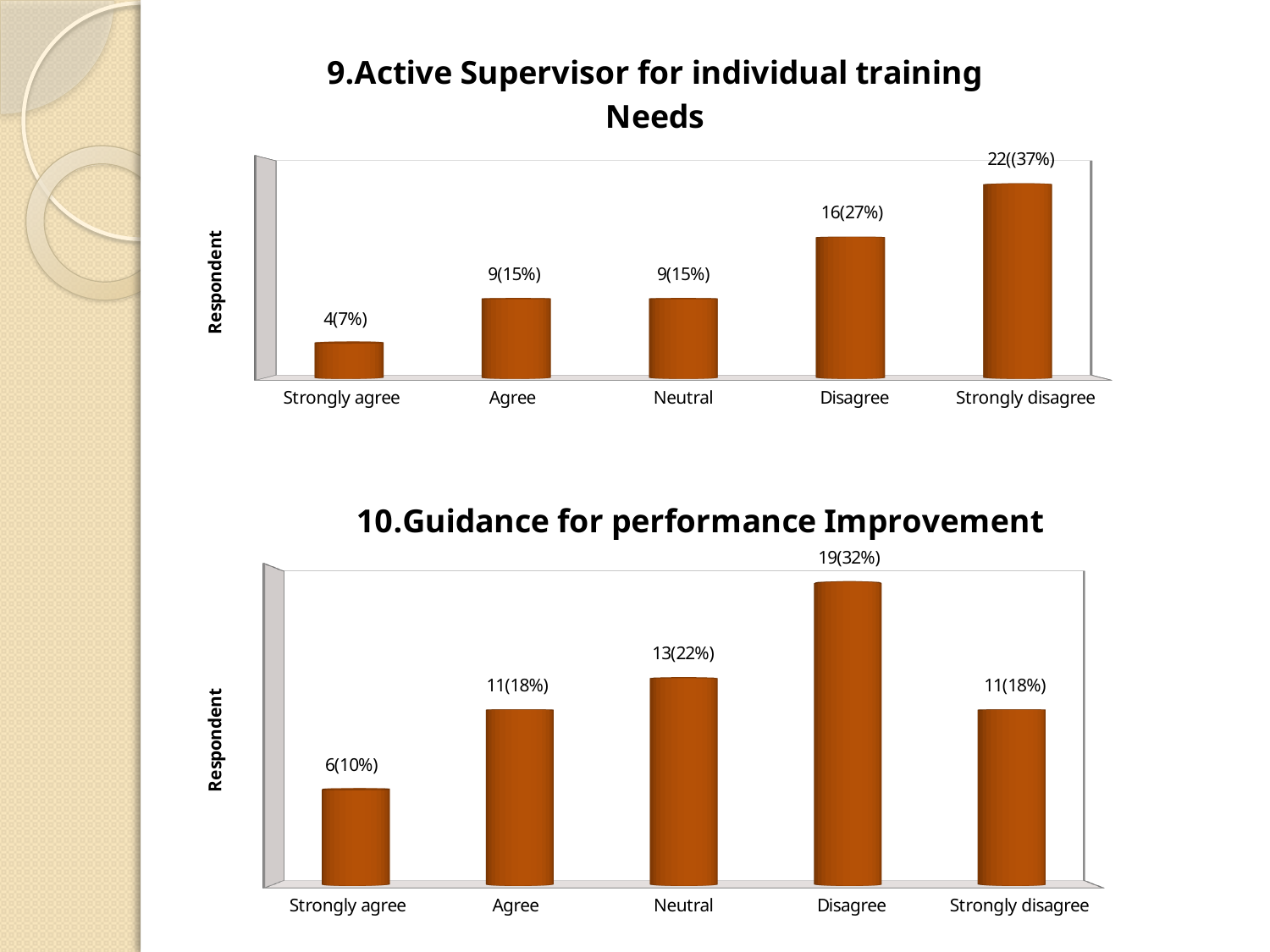
In the chart titled '9.Active Supervisor for individual training Needs', what is the difference in respondent count between Disagree and Agree? 7 In the chart titled '10.Guidance for performance Improvement', which category has the highest value? Disagree In the chart titled '10.Guidance for performance Improvement', what is the difference in respondent count between Disagree and Strongly agree? 13 In the chart titled '10.Guidance for performance Improvement', which category has the lowest value? Strongly agree In the chart titled '9.Active Supervisor for individual training Needs', what is the data label for Disagree? 16(27%) In the chart titled '9.Active Supervisor for individual training Needs', how many categories are shown on the x axis? 5 In the chart titled '10.Guidance for performance Improvement', which is larger, the value for Neutral or the value for Strongly disagree? Neutral In the chart titled '9.Active Supervisor for individual training Needs', which category has the highest value? Strongly disagree In the chart titled '9.Active Supervisor for individual training Needs', do the values rise or fall from Strongly agree to Strongly disagree? rise In the chart titled '9.Active Supervisor for individual training Needs', which category has the lowest value? Strongly agree In the chart titled '10.Guidance for performance Improvement', what is the data label for Neutral? 13(22%) What kind of chart is the chart titled '10.Guidance for performance Improvement'? bar chart